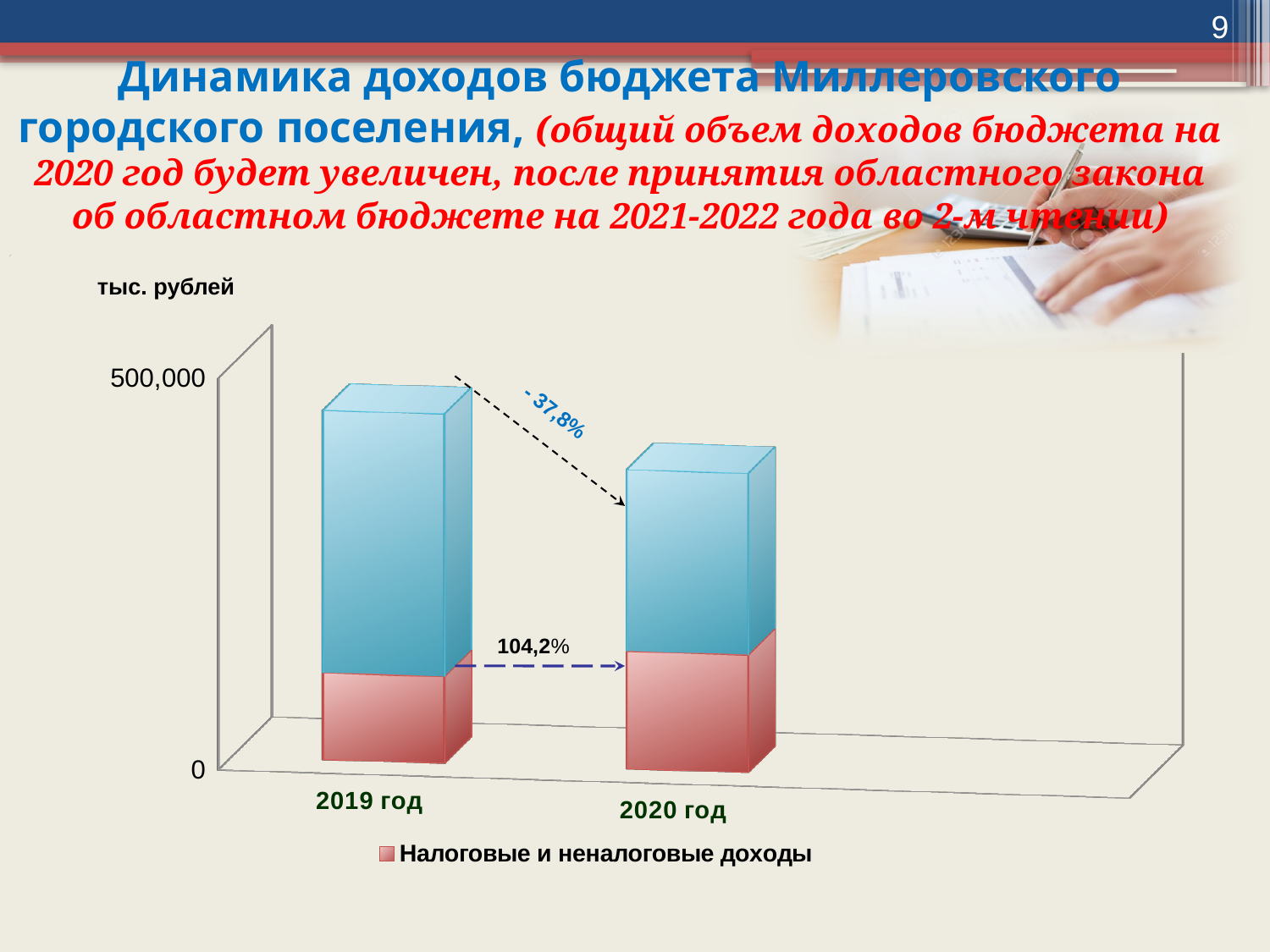
What is the name of the series listed in the chart legend? Налоговые и неналоговые доходы Which year has the taller total bar, 2019 год or 2020 год? 2019 год Do the total bar heights rise or fall from 2019 год to 2020 год? fall What unit is shown above the vertical axis of the chart? тыс. рублей How many years (categories) are shown on the x axis of the chart? 2 Which year has the highest total bar in the chart? 2019 год What percentage is annotated on the arrow between the red segments of the 2019 and 2020 bars? 104,2% How many series does the chart legend list? 1 Which year has the lowest total bar in the chart? 2020 год What percentage change is annotated between the tops of the 2019 and 2020 bars? - 37,8% What is the highest tick value labelled on the vertical axis? 500,000 What kind of chart is shown on the slide? bar chart